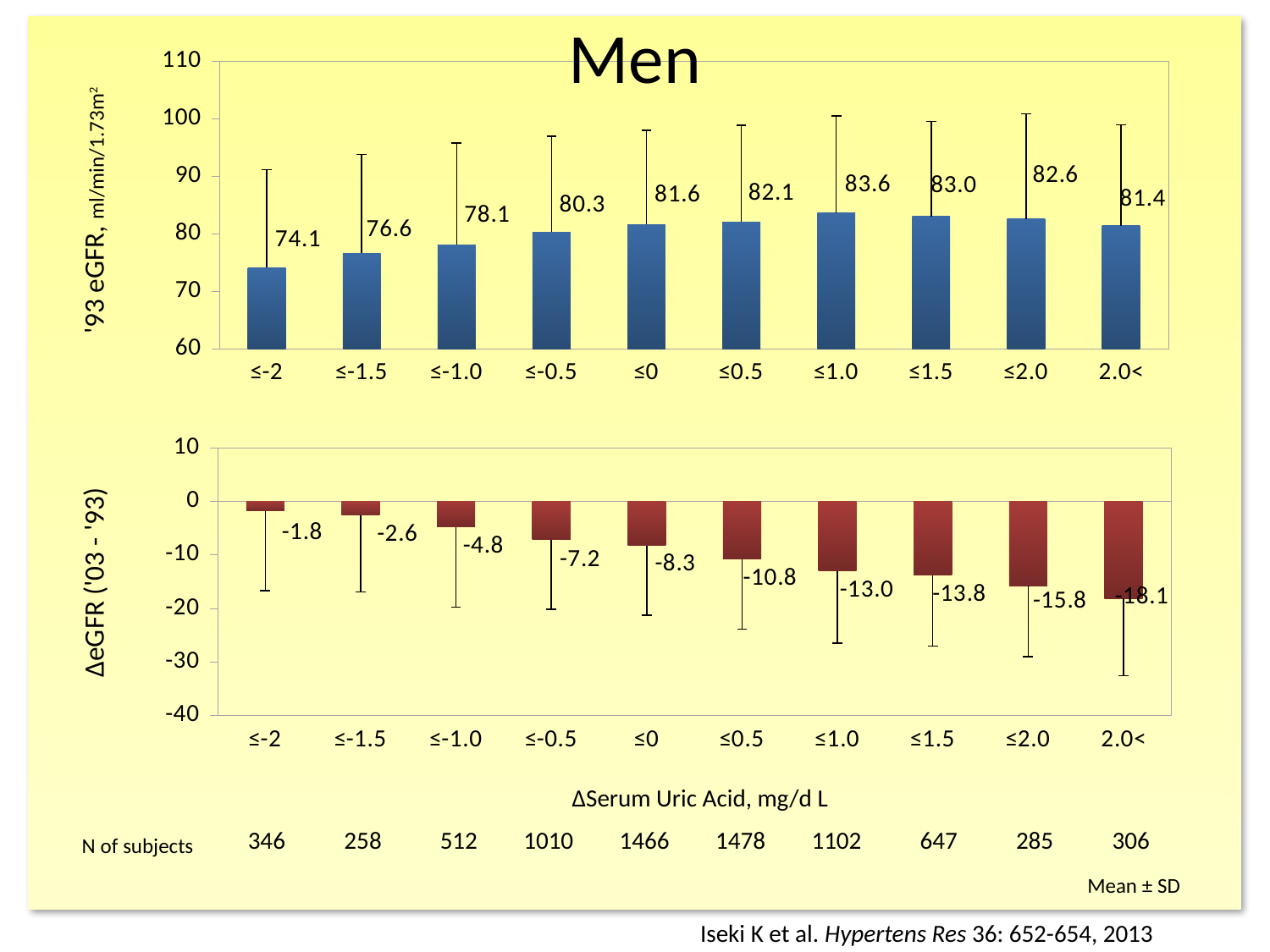
In the bottom chart (ΔeGFR), which category has the highest value? ≤-2 In the bottom chart (ΔeGFR), do the values rise or fall from left to right along the x axis? fall How many categories are shown on the x axis of the top chart? 10 In the top chart ('93 eGFR), which category has the lowest value? ≤-2 In the bottom chart (ΔeGFR), is the value for ≤-1.0 larger or smaller than the value for ≤2.0? larger What kind of chart is the top chart? bar chart In the bottom chart (ΔeGFR), which category has the lowest value? 2.0< In the bottom chart (ΔeGFR), what is the difference between the values for ≤-2 and 2.0<? 16.3 In the top chart ('93 eGFR), which category has the highest value? ≤1.0 In the top chart ('93 eGFR), what is the difference between the values for ≤1.0 and ≤-2? 9.5 In the top chart ('93 eGFR), what is the value for the ≤-2 category? 74.1 In the bottom chart (ΔeGFR), what is the value for the ≤0.5 category? -10.8